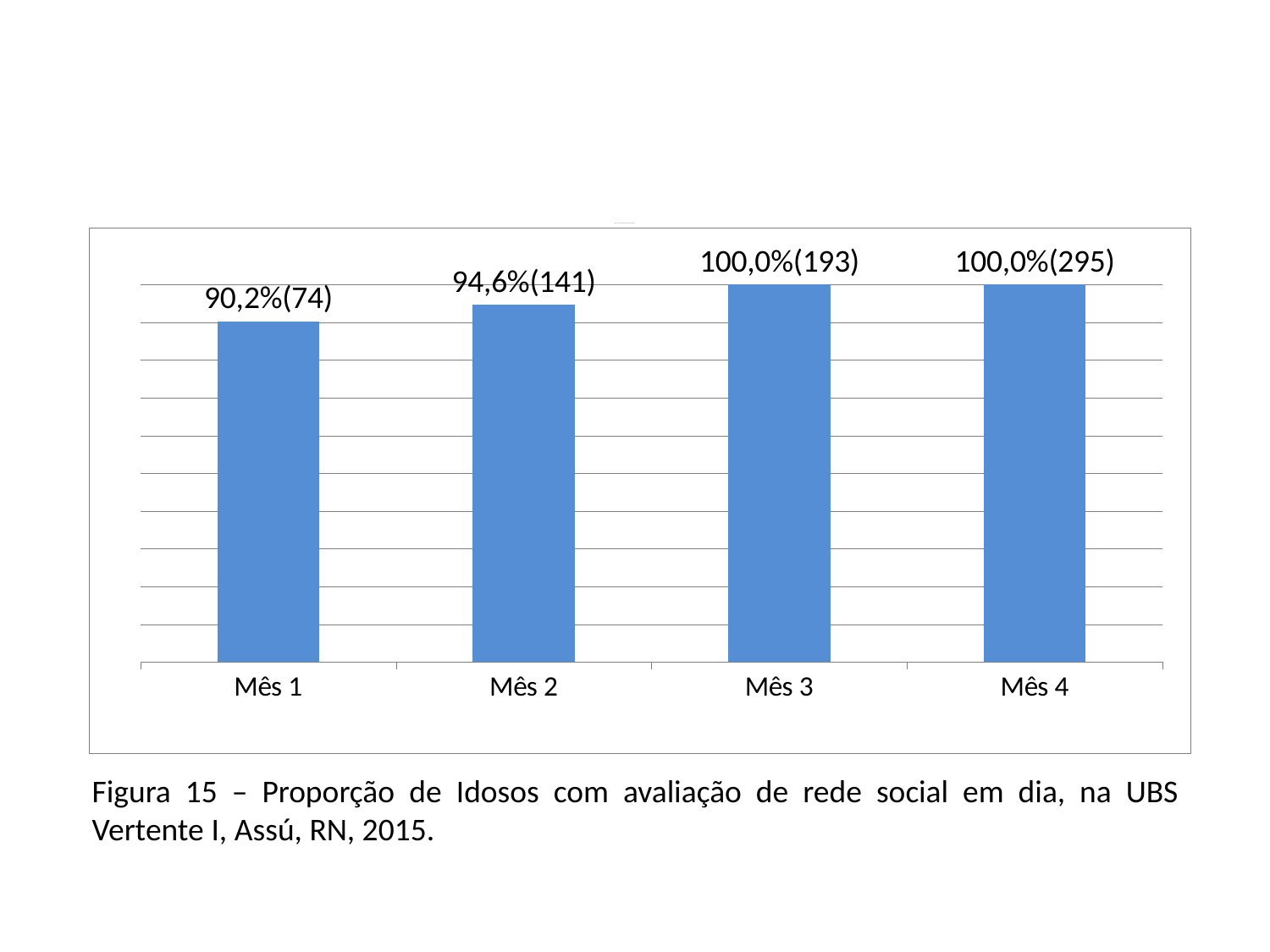
What is the count in parentheses shown for Mês 3? 193 Do the percentages rise or fall from Mês 1 to Mês 4? Rise What is the data label shown for Mês 1? 90,2%(74) Which months reach 100,0%? Mês 3 and Mês 4 What kind of chart is shown on the slide? Bar chart How many months are shown on the x axis? 4 What is the data label shown for Mês 4? 100,0%(295) What percentage is shown for Mês 2? 94,6% How many more idosos are counted in Mês 4 than in Mês 3? 102 Which has a higher percentage, Mês 1 or Mês 2? Mês 2 What is the difference in percentage points between Mês 2 and Mês 1? 4,4 Which month has the lowest percentage? Mês 1